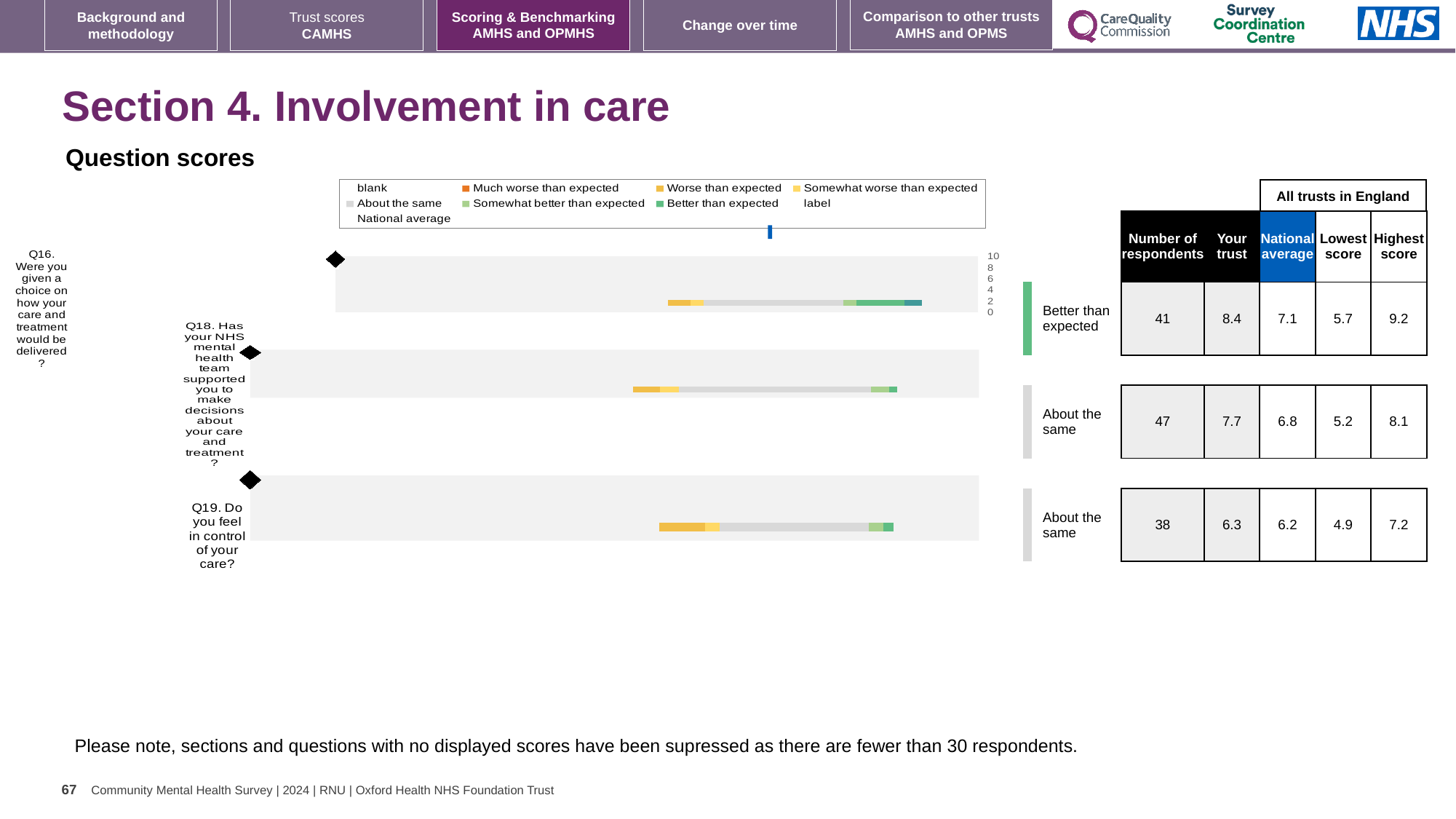
What kind of chart is used to show the question scores for Q16, Q18 and Q19? bar chart What is the 'Your trust' score for Q16 (Were you given a choice on how your care and treatment would be delivered?)? 8.4 What is the lowest score among all trusts in England for Q18? 5.2 Which question has the lowest national average score? Q19 What benchmark category is shown next to the Q16 bar? Better than expected Which question has the highest 'Your trust' score? Q16 What is the national average score for Q18 (Has your NHS mental health team supported you to make decisions about your care and treatment?)? 6.8 What is the highest score among all trusts in England for Q19? 7.2 How many respondents answered Q19 (Do you feel in control of your care?)? 38 How many questions are plotted in the question scores chart? 3 For Q18, which is larger: the 'Your trust' score or the national average? Your trust For Q16, how much higher is the 'Your trust' score than the national average? 1.3